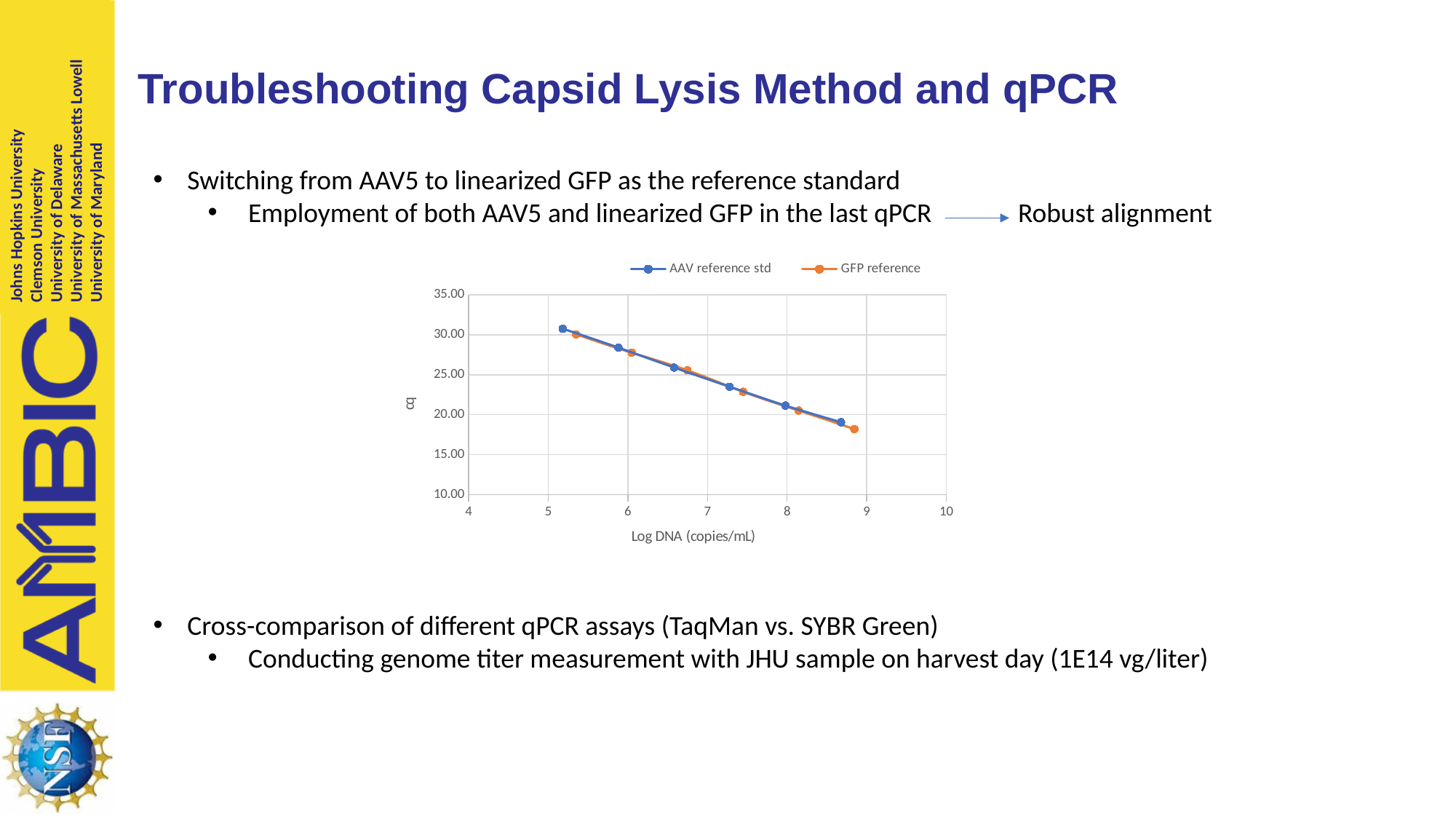
Is the Cq value of the rightmost GFP reference point greater or less than 20.00? less How many data points are plotted for the AAV reference std series? 6 Do the Cq values rise or fall as Log DNA increases along the x axis? fall What is the x-axis title of the chart? Log DNA (copies/mL) What are the two series named in the chart legend? AAV reference std and GFP reference Is the Cq value of the second AAV reference std point from the left greater or less than 30.00? less How many series does the chart legend list? 2 Is the Cq value of the leftmost AAV reference std point greater or less than 25.00? greater How many data points are plotted for the GFP reference series? 6 What kind of chart is shown on the slide? line chart